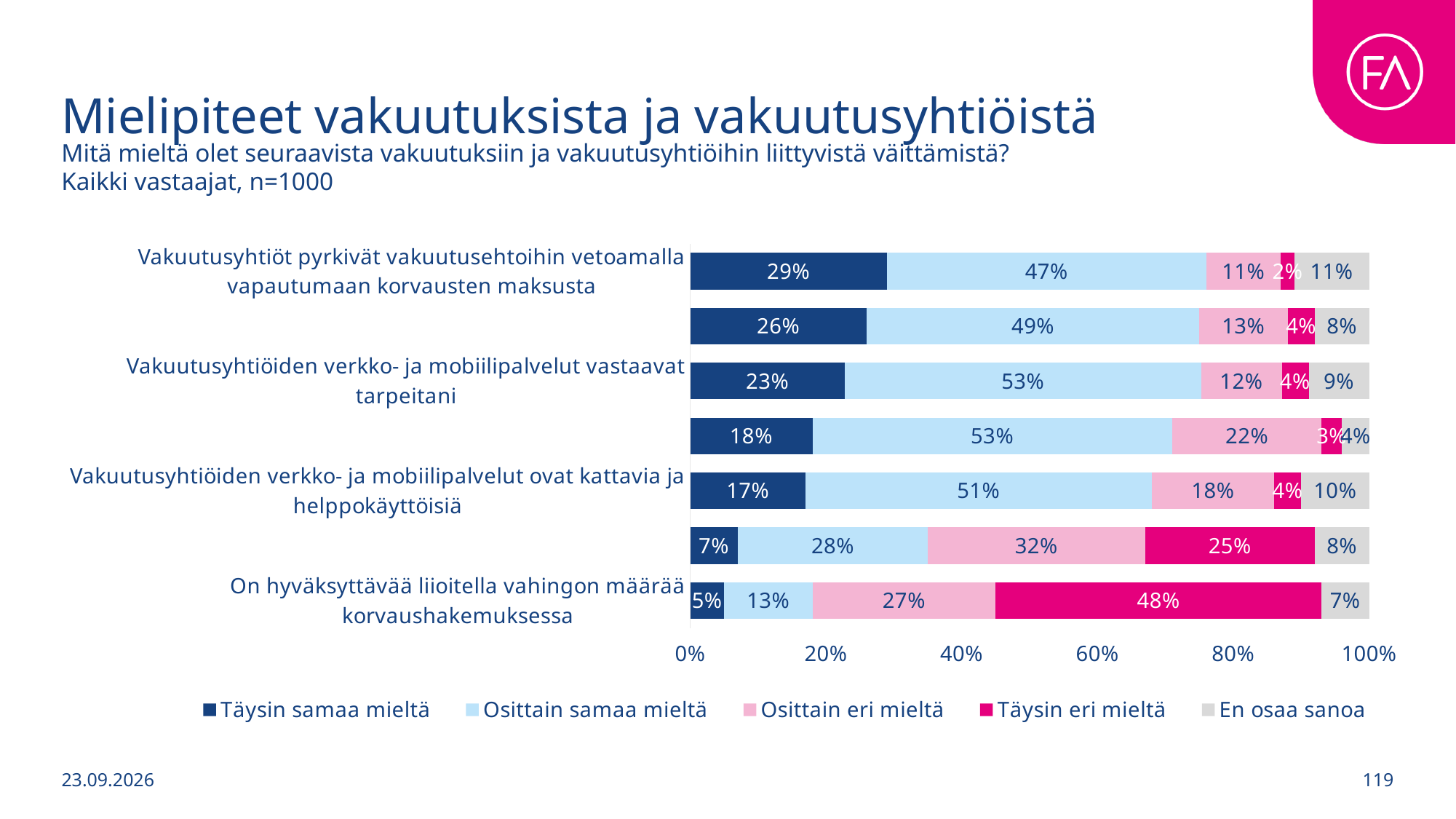
Which has a larger 'Osittain samaa mieltä' share: 'Vakuutusyhtiöiden verkko- ja mobiilipalvelut vastaavat tarpeitani' or 'Vakuutusyhtiöiden verkko- ja mobiilipalvelut ovat kattavia ja helppokäyttöisiä'? Vakuutusyhtiöiden verkko- ja mobiilipalvelut vastaavat tarpeitani What is the 'Osittain samaa mieltä' share for 'Vakuutusyhtiöiden verkko- ja mobiilipalvelut vastaavat tarpeitani'? 53% Which statement has the highest 'Täysin samaa mieltä' share? Vakuutusyhtiöt pyrkivät vakuutusehtoihin vetoamalla vapautumaan korvausten maksusta What kind of chart is shown on the slide? Stacked bar chart What is the first entry listed in the chart legend? Täysin samaa mieltä What is the 'En osaa sanoa' share for 'Vakuutusyhtiöiden verkko- ja mobiilipalvelut ovat kattavia ja helppokäyttöisiä'? 10% For 'Vakuutusyhtiöt pyrkivät vakuutusehtoihin vetoamalla vapautumaan korvausten maksusta', what is the difference between the 'Osittain samaa mieltä' and 'Osittain eri mieltä' shares? 36 percentage points How many series does the legend list? 5 How many bars (statements) are plotted in the chart? 7 Which statement has the highest 'Täysin eri mieltä' share? On hyväksyttävää liioitella vahingon määrää korvaushakemuksessa What is the 'Täysin samaa mieltä' share for 'Vakuutusyhtiöt pyrkivät vakuutusehtoihin vetoamalla vapautumaan korvausten maksusta'? 29% What is the 'Täysin eri mieltä' share for 'On hyväksyttävää liioitella vahingon määrää korvaushakemuksessa'? 48%